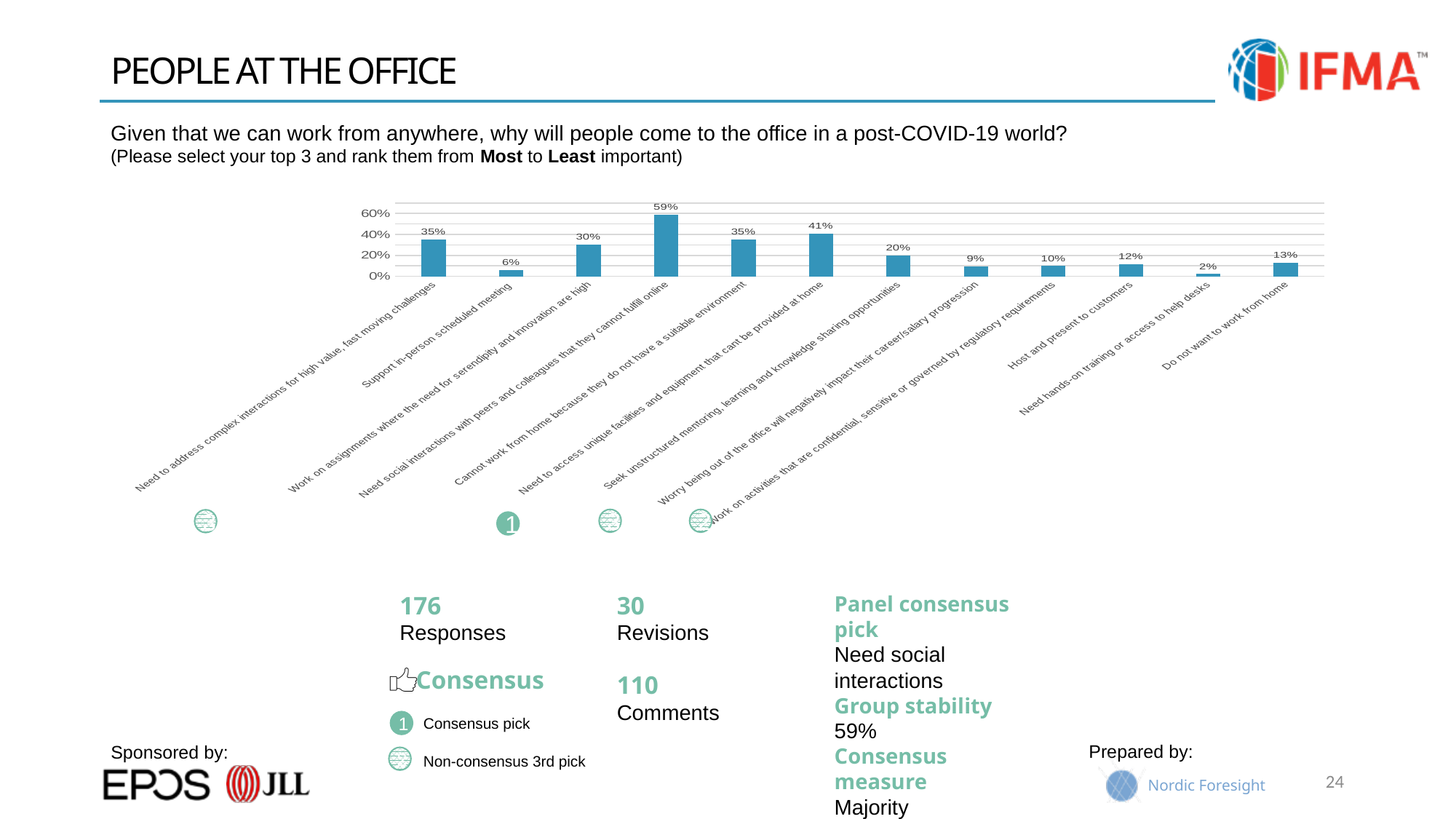
What type of chart is shown on the slide? Bar chart What is the difference between the values for "Need social interactions with peers and colleagues that they cannot fulfill online" and "Need to access unique facilities and equipment that cant be provided at home"? 18% What is the highest value shown on the chart's vertical axis? 60% Which category has the lowest value in the chart? Need hands-on training or access to help desks What percentage is shown for "Do not want to work from home"? 13% Which is larger: the value for "Work on assignments where the need for serendipity and innovation are high" or the value for "Seek unstructured mentoring, learning and knowledge sharing opportunities"? Work on assignments where the need for serendipity and innovation are high Which category has the highest value in the chart? Need social interactions with peers and colleagues that they cannot fulfill online How many categories are plotted in the chart? 12 What percentage is shown for "Support in-person scheduled meeting"? 6% What percentage is shown for "Need social interactions with peers and colleagues that they cannot fulfill online"? 59% Is the value for "Need to address complex interactions for high value, fast moving challenges" greater or less than 20%? greater What percentage is shown for "Need to access unique facilities and equipment that cant be provided at home"? 41%